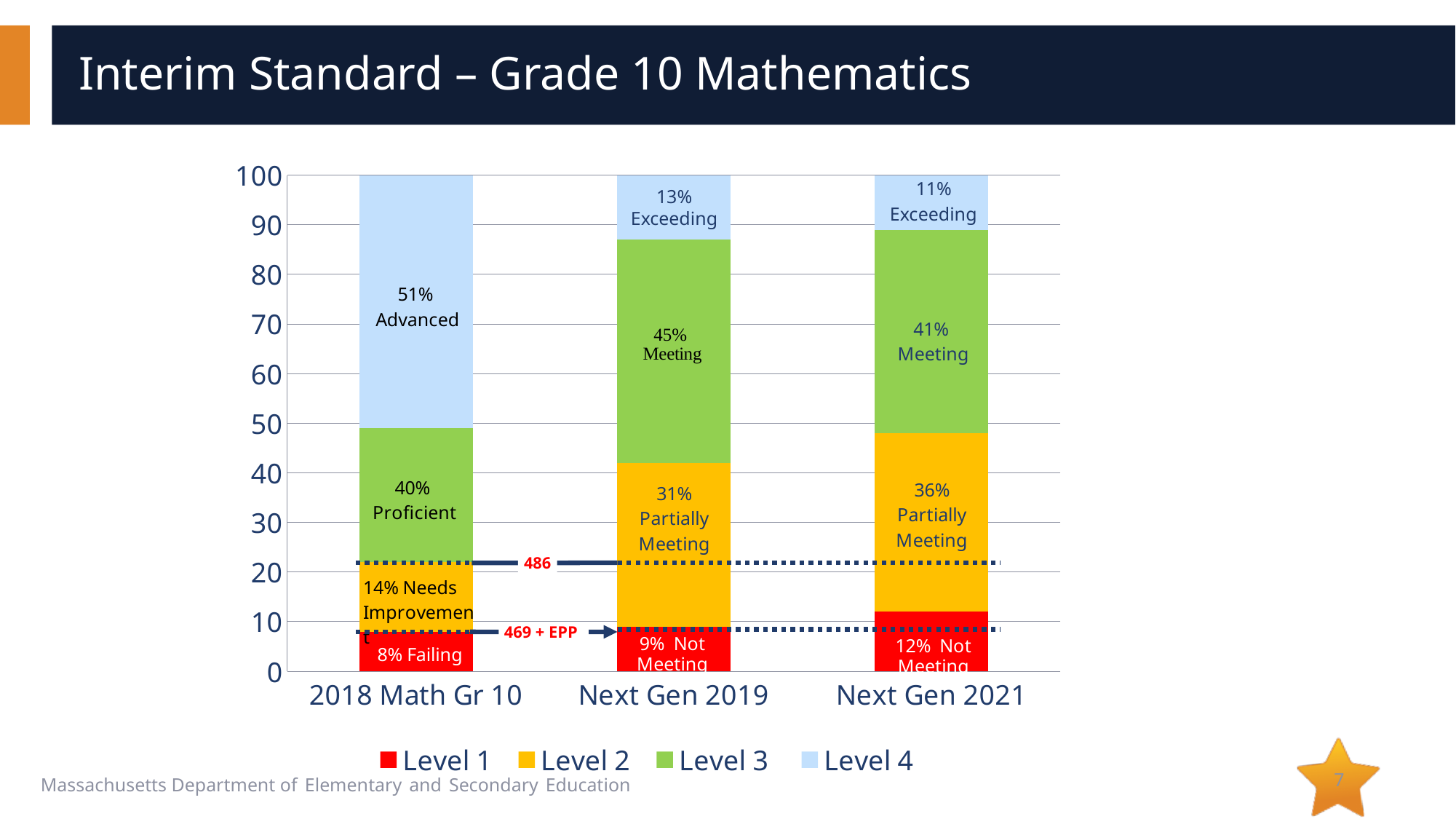
What percentage of students were Meeting in Next Gen 2019? 45% What percentage of students were Advanced in 2018 Math Gr 10? 51% How many series does the legend list? 4 What percentage of students were Exceeding in Next Gen 2021? 11% What is the difference between the Meeting percentage in Next Gen 2019 and in Next Gen 2021? 4% How many categories are shown on the x axis? 3 What colour represents Level 2 in the legend? yellow Which is larger: the Not Meeting percentage in Next Gen 2019 or in Next Gen 2021? Next Gen 2021 What percentage of students were Partially Meeting in Next Gen 2021? 36% What percentage of students were Failing in 2018 Math Gr 10? 8% What type of chart is shown on the slide? stacked bar chart Which category has the highest Level 4 (top segment) percentage? 2018 Math Gr 10